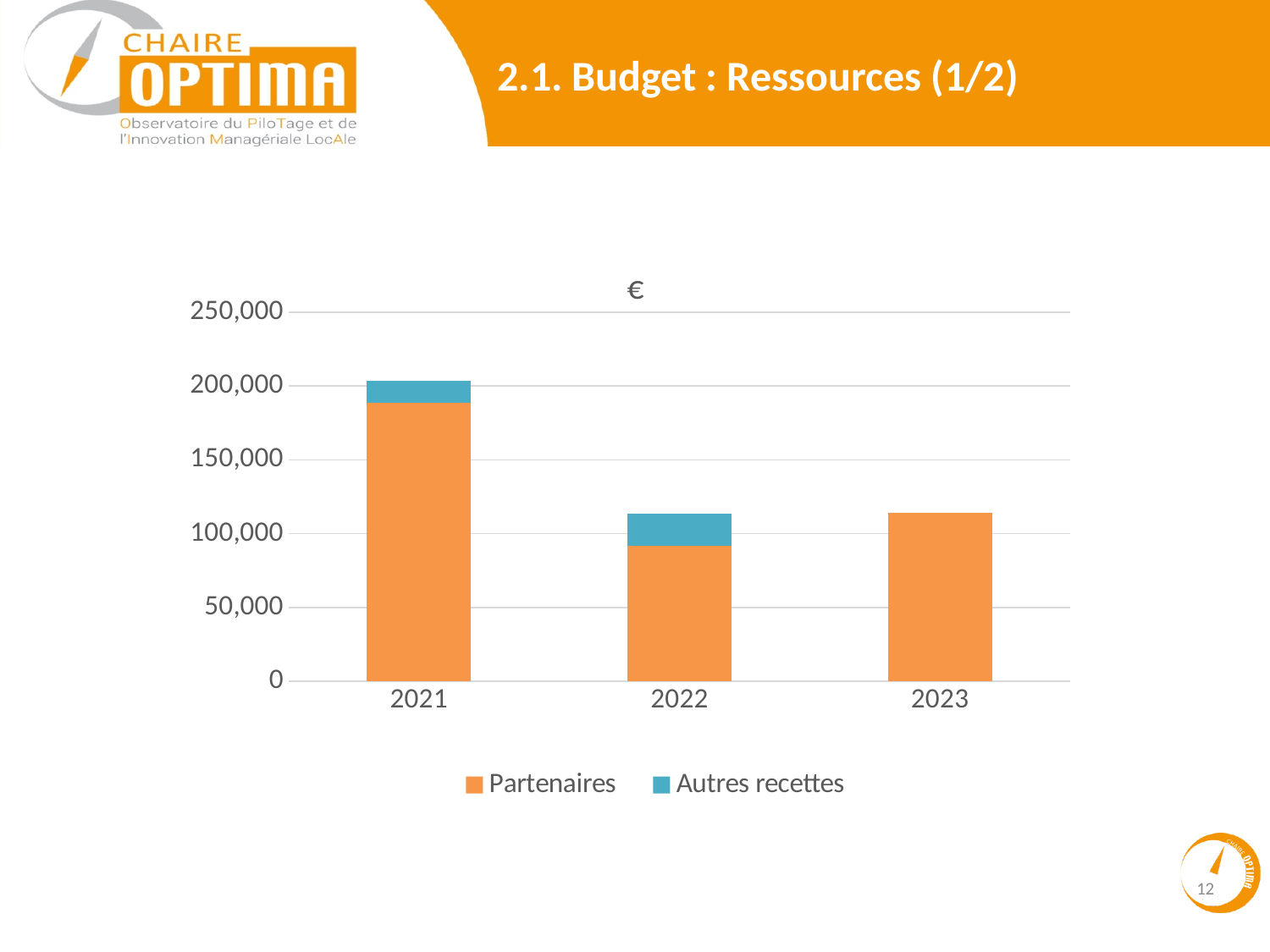
Is the Partenaires value for 2023 greater or less than 100,000? greater Is the total bar for 2021 greater or less than 200,000? greater How many series does the chart's legend list? 2 Is the Partenaires value for 2022 greater or less than 100,000? less Which is larger, the Partenaires value for 2022 or for 2023? 2023 What are the two series named in the chart's legend? Partenaires and Autres recettes Which year has the highest total bar in the chart? 2021 Which is larger, the Partenaires value for 2021 or for 2022? 2021 Which year has the lowest Partenaires value? 2022 How many years are shown on the x axis of the chart? 3 What kind of chart is shown on the slide? Stacked bar chart Which year shows no Autres recettes segment in its bar? 2023